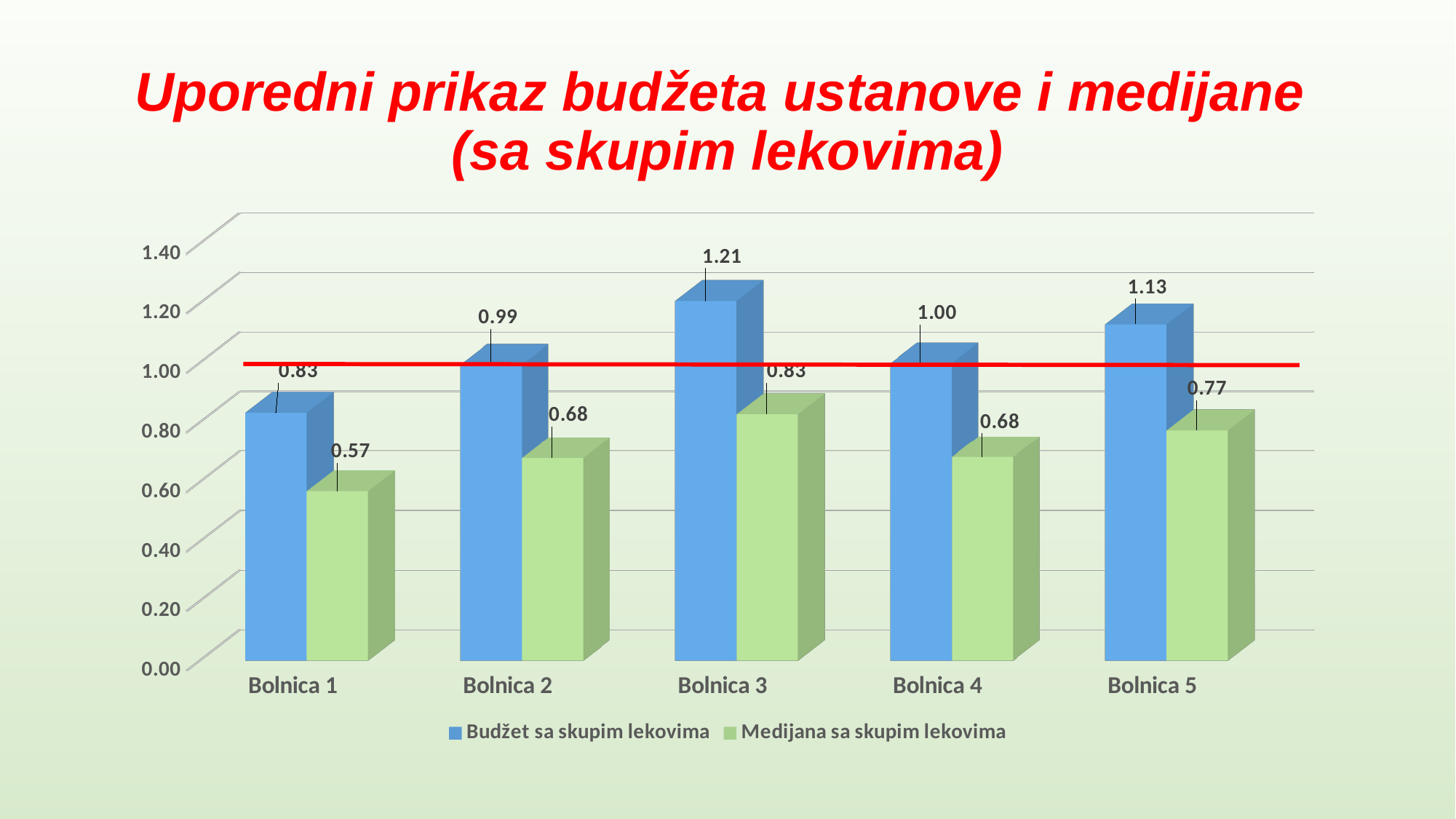
What is the value of 'Budžet sa skupim lekovima' for Bolnica 5? 1.13 How many series does the legend list? 2 What kind of chart is shown on the slide? Bar chart What is the value of 'Budžet sa skupim lekovima' for Bolnica 3? 1.21 Which hospital has the highest 'Budžet sa skupim lekovima' value? Bolnica 3 Which hospital has the lowest 'Medijana sa skupim lekovima' value? Bolnica 1 Which is larger: the 'Budžet sa skupim lekovima' value for Bolnica 2 or for Bolnica 5? Bolnica 5 Is the 'Budžet sa skupim lekovima' value for Bolnica 1 greater or less than 1.00? less What is the value of 'Medijana sa skupim lekovima' for Bolnica 1? 0.57 How many hospitals (categories) are shown on the x axis? 5 What is the difference between the 'Budžet sa skupim lekovima' and 'Medijana sa skupim lekovima' values for Bolnica 3? 0.38 Which colour represents 'Medijana sa skupim lekovima' in the chart? Green